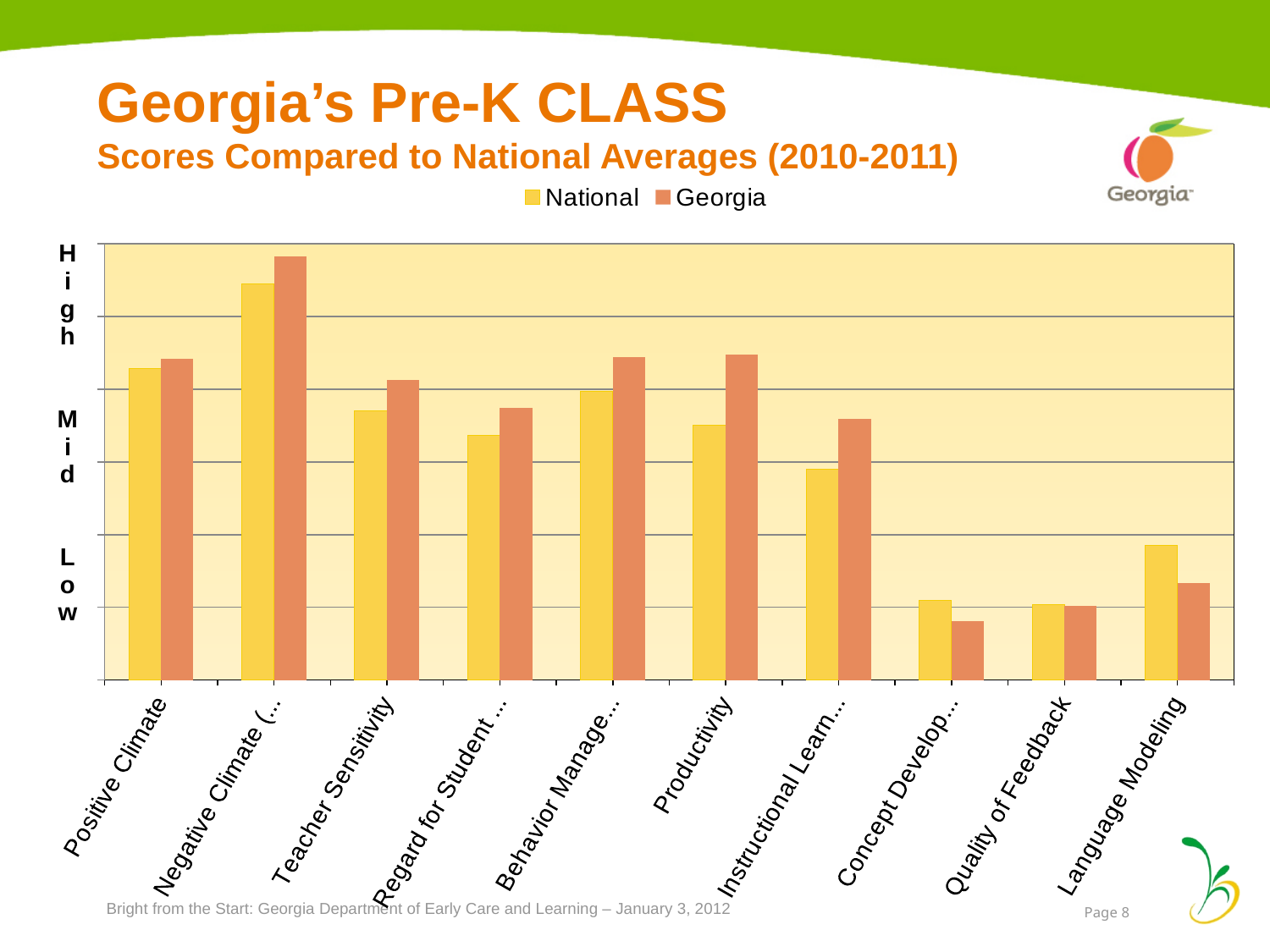
Which series is shown in yellow? National Which category has the highest Georgia score? Negative Climate What kind of chart is shown on the slide? bar chart For Language Modeling, which is higher: the National score or the Georgia score? National For Teacher Sensitivity, which is higher: the National score or the Georgia score? Georgia For Concept Development, which is higher: the National score or the Georgia score? National How many series does the legend list? 2 Which category has the highest National score? Negative Climate What are the two series named in the legend? National and Georgia How many categories are plotted along the x axis? 10 Which category has the lowest Georgia score? Concept Development